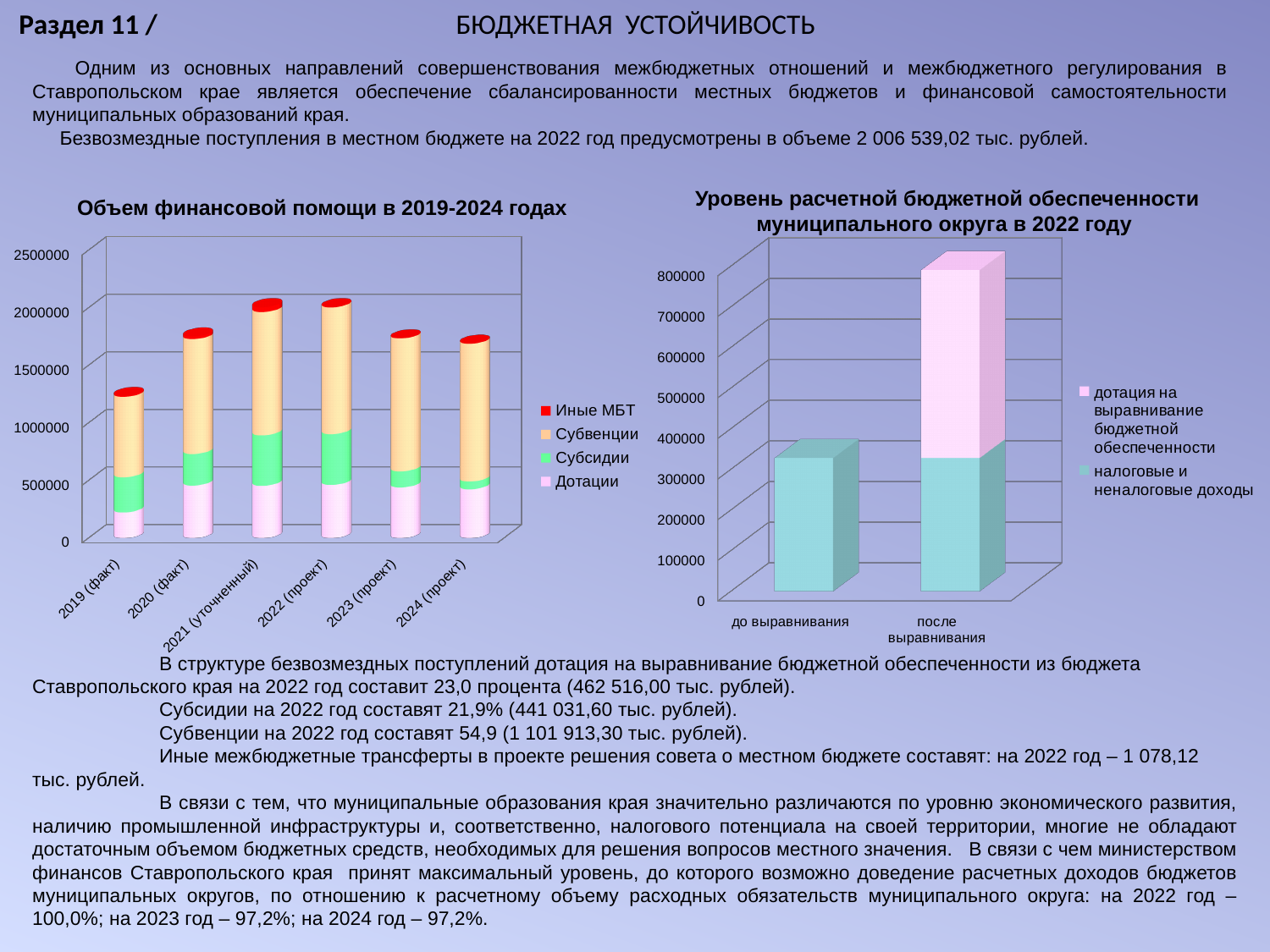
In the chart "Объем финансовой помощи в 2019-2024 годах", is the total bar for 2019 (факт) greater or less than 1500000? less How many categories are shown on the x axis of the chart "Объем финансовой помощи в 2019-2024 годах"? 6 In the chart "Уровень расчетной бюджетной обеспеченности муниципального округа в 2022 году", which category has the higher total bar? после выравнивания What kind of chart is the chart titled "Объем финансовой помощи в 2019-2024 годах"? stacked bar chart In the chart "Уровень расчетной бюджетной обеспеченности муниципального округа в 2022 году", is the bar for "до выравнивания" greater or less than 400000? less In the chart "Объем финансовой помощи в 2019-2024 годах", which category has the lowest total bar? 2019 (факт) In the chart "Объем финансовой помощи в 2019-2024 годах", which series is shown in red in the legend? Иные МБТ In the chart "Объем финансовой помощи в 2019-2024 годах", is the total bar for 2021 (уточненный) greater or less than 1500000? greater How many categories are shown on the x axis of the chart "Уровень расчетной бюджетной обеспеченности муниципального округа в 2022 году"? 2 How many series does the legend of the chart "Объем финансовой помощи в 2019-2024 годах" list? 4 What kind of chart is the chart titled "Уровень расчетной бюджетной обеспеченности муниципального округа в 2022 году"? stacked bar chart How many series does the legend of the chart "Уровень расчетной бюджетной обеспеченности муниципального округа в 2022 году" list? 2